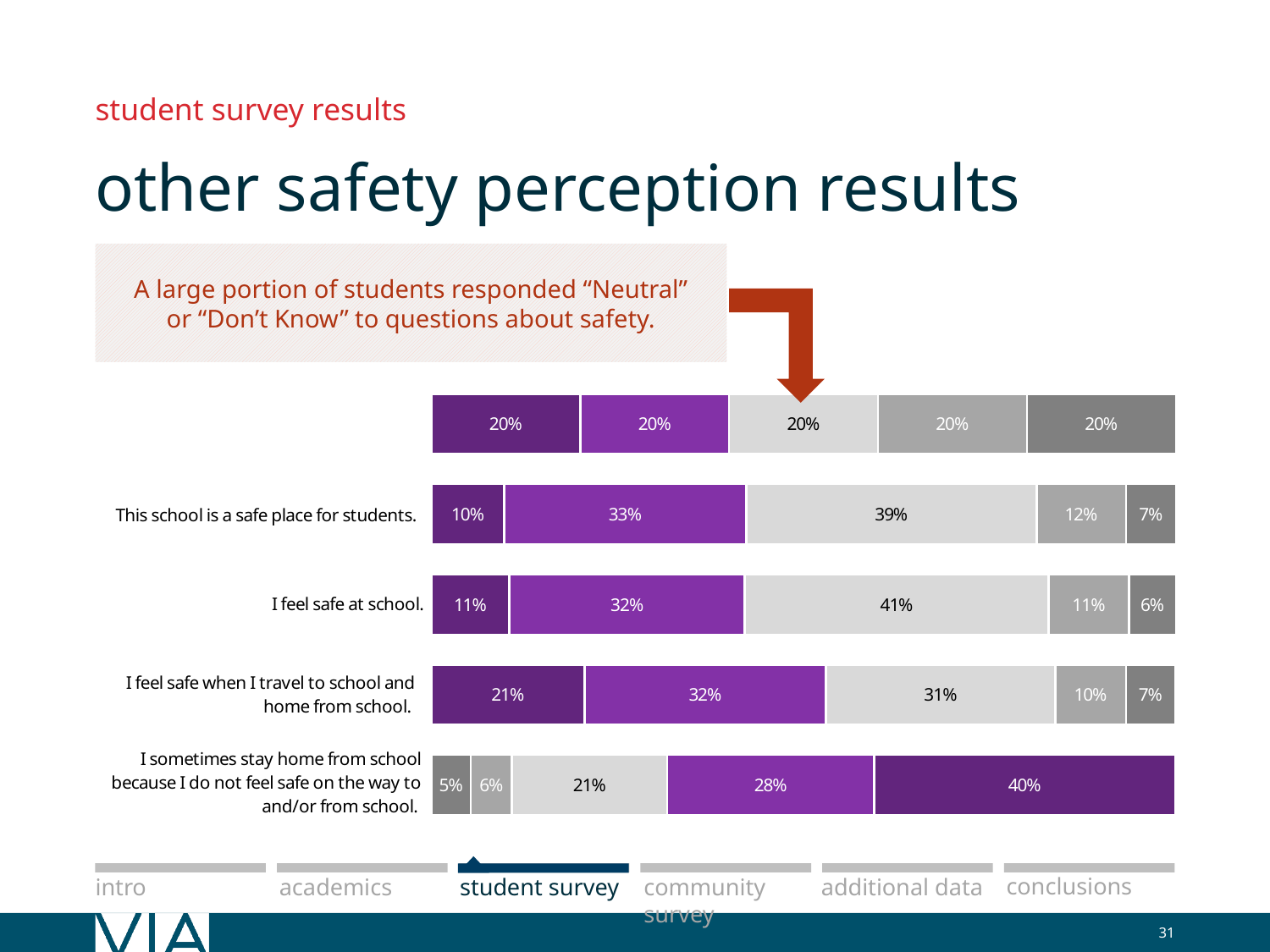
Which has the larger dark purple first segment: "This school is a safe place for students." or "I feel safe when I travel to school and home from school."? I feel safe when I travel to school and home from school. What is the smallest segment value in the bar for "I sometimes stay home from school because I do not feel safe on the way to and/or from school."? 5% Which statement has the largest light gray middle segment? I feel safe at school. What is the value of the light gray middle segment for "I feel safe at school."? 41% How many segments does each bar in the chart contain? 5 What is the value of the light gray middle segment for "This school is a safe place for students."? 39% How many survey statements are labeled on the chart? 4 What is the difference between the light gray segments for "I feel safe at school." and "This school is a safe place for students."? 2 percentage points What kind of chart is shown on the slide? Stacked bar chart What does the callout box above the chart say? A large portion of students responded "Neutral" or "Don't Know" to questions about safety. What is the value of the dark purple segment for "I sometimes stay home from school because I do not feel safe on the way to and/or from school."? 40% What is the value of the first (dark purple) segment for "I feel safe when I travel to school and home from school."? 21%